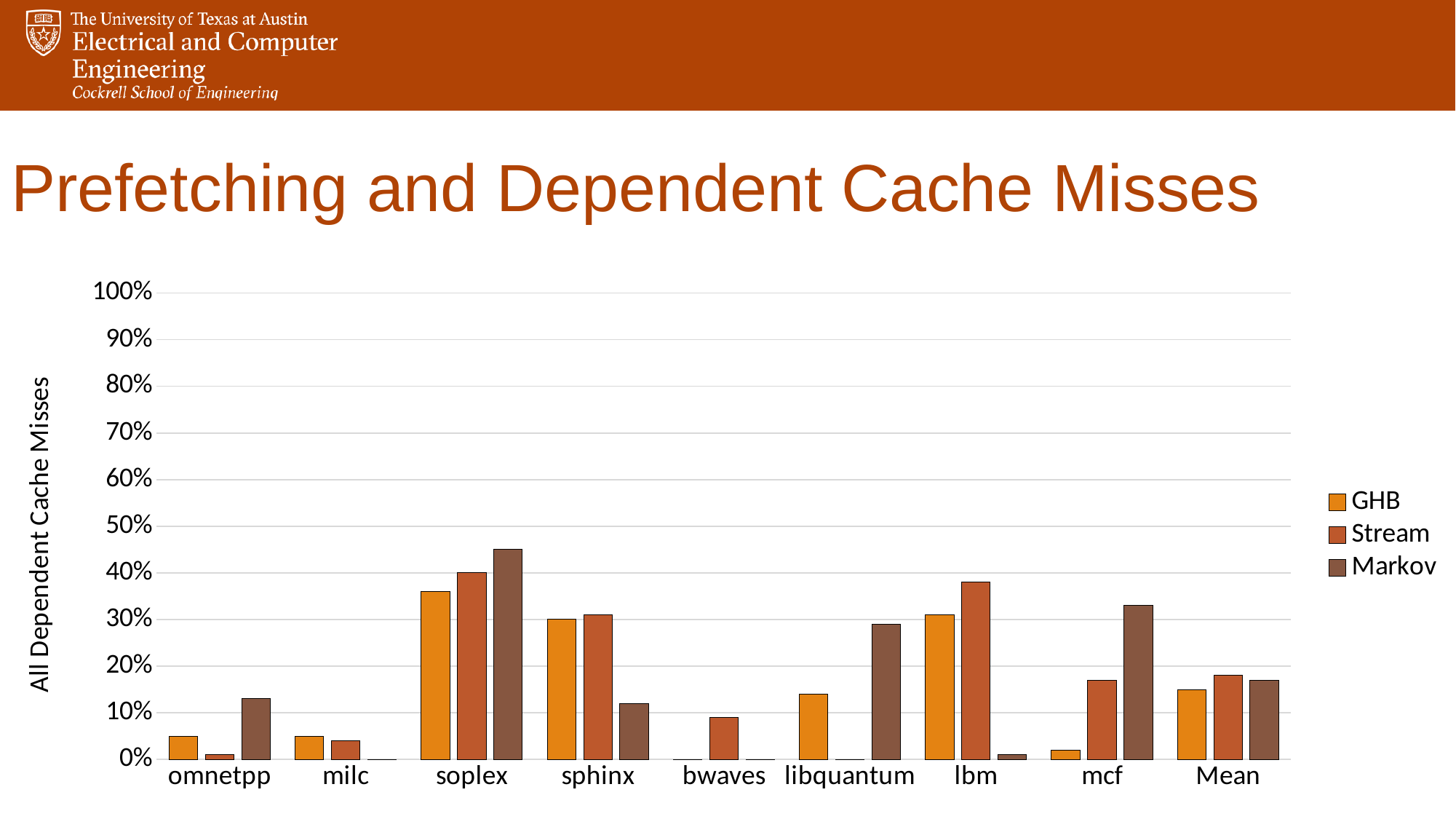
Is the Markov value for sphinx greater or less than 20%? less What is the label on the y axis? All Dependent Cache Misses Which series has the tallest bar for lbm? Stream What kind of chart is shown on the slide? bar chart How many categories are shown along the x axis? 9 For libquantum, which is larger: the GHB value or the Markov value? Markov For mcf, which is larger: the Stream value or the Markov value? Markov Which category has the highest Markov bar? soplex Is the GHB value for omnetpp greater or less than 10%? less How many series does the legend list? 3 Is the Stream value for lbm greater or less than 30%? greater